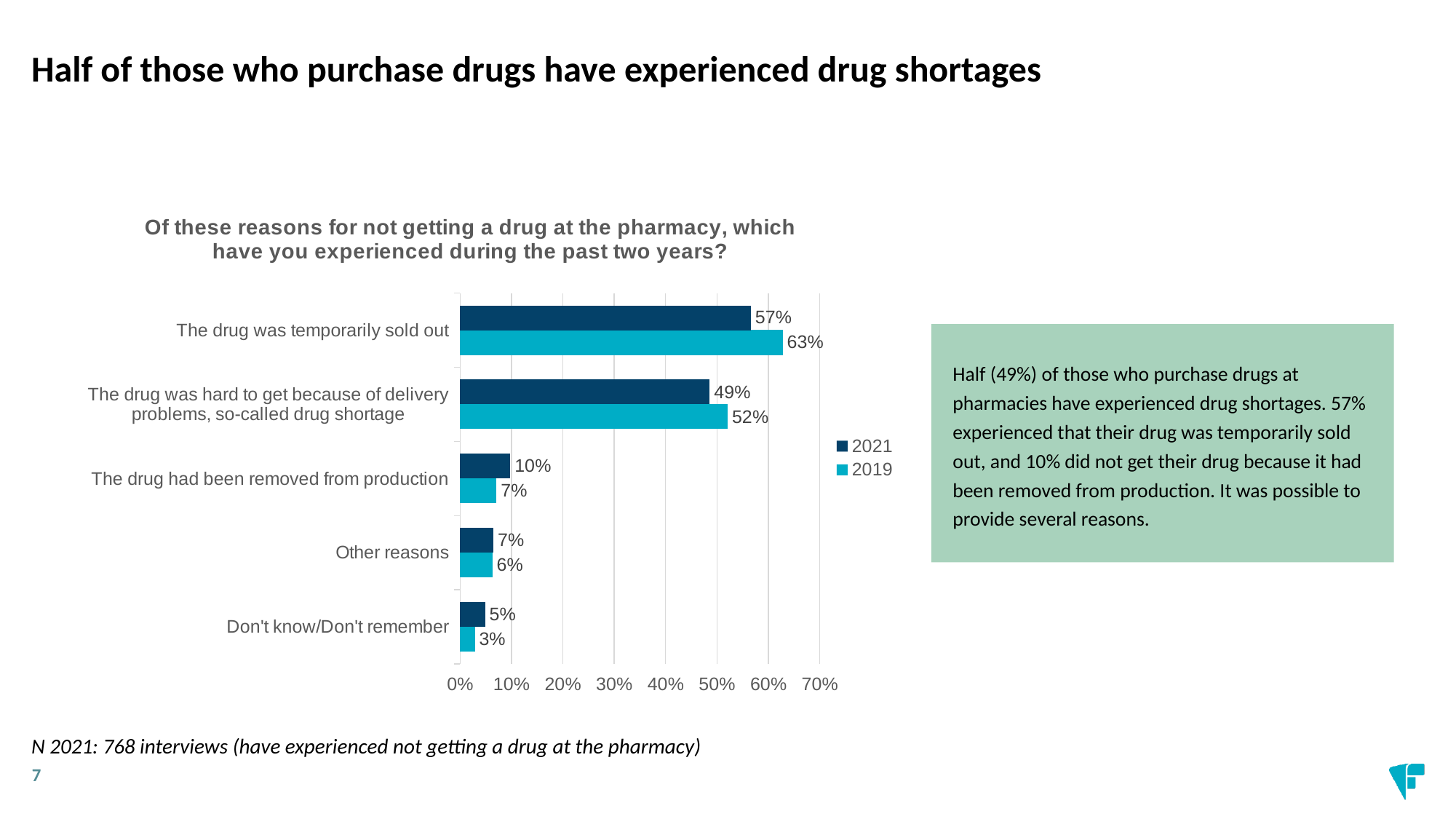
What type of chart is shown on the slide? Bar chart Which years are listed in the chart legend? 2021 and 2019 Which reason had the highest value in 2019? The drug was temporarily sold out Which reason had the lowest value in 2021? Don't know/Don't remember What percentage in 2021 said the drug had been removed from production? 10% What percentage of respondents in 2021 said the drug was temporarily sold out? 57% What was the 2019 value for 'Don't know/Don't remember'? 3% What was the 2019 value for 'The drug was hard to get because of delivery problems, so-called drug shortage'? 52% How many series does the legend list? 2 How many reasons (categories) are shown on the chart? 5 For 'Other reasons', which year had the larger value, 2021 or 2019? 2021 What is the difference between the 2019 and 2021 values for 'The drug was temporarily sold out'? 6 percentage points